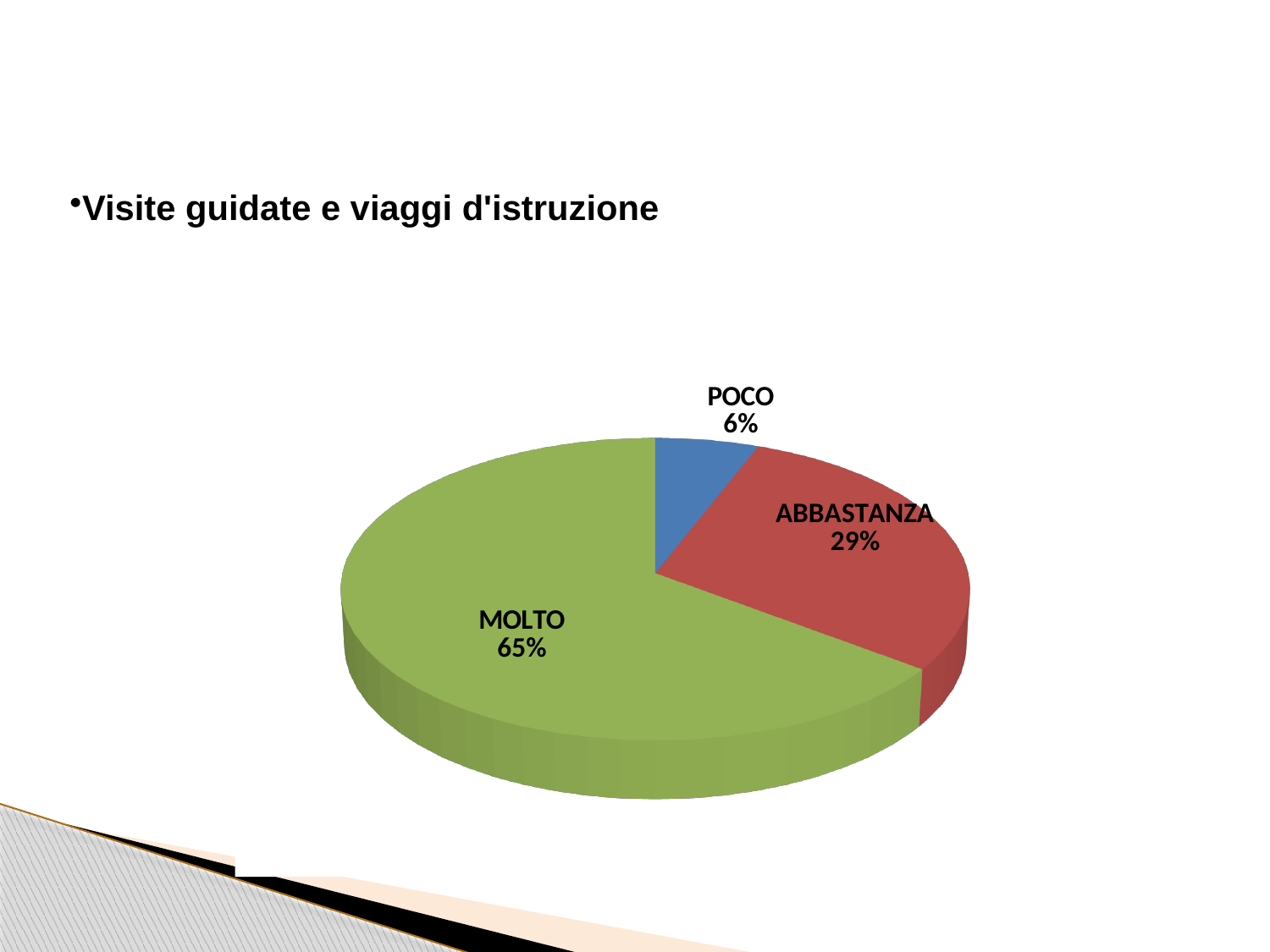
What kind of chart is shown on the slide? pie chart What is the title text above the chart? Visite guidate e viaggi d'istruzione What is the difference in percentage points between ABBASTANZA and POCO? 23 What share of the pie does POCO represent? 6% What share of the pie does MOLTO represent? 65% What colour is the MOLTO slice? green Which category has the largest slice of the pie? MOLTO What share of the pie does ABBASTANZA represent? 29% Which is larger, the share for ABBASTANZA or the share for POCO? ABBASTANZA Which category has the smallest slice of the pie? POCO How many slices does the pie chart have? 3 What is the difference in percentage points between MOLTO and ABBASTANZA? 36